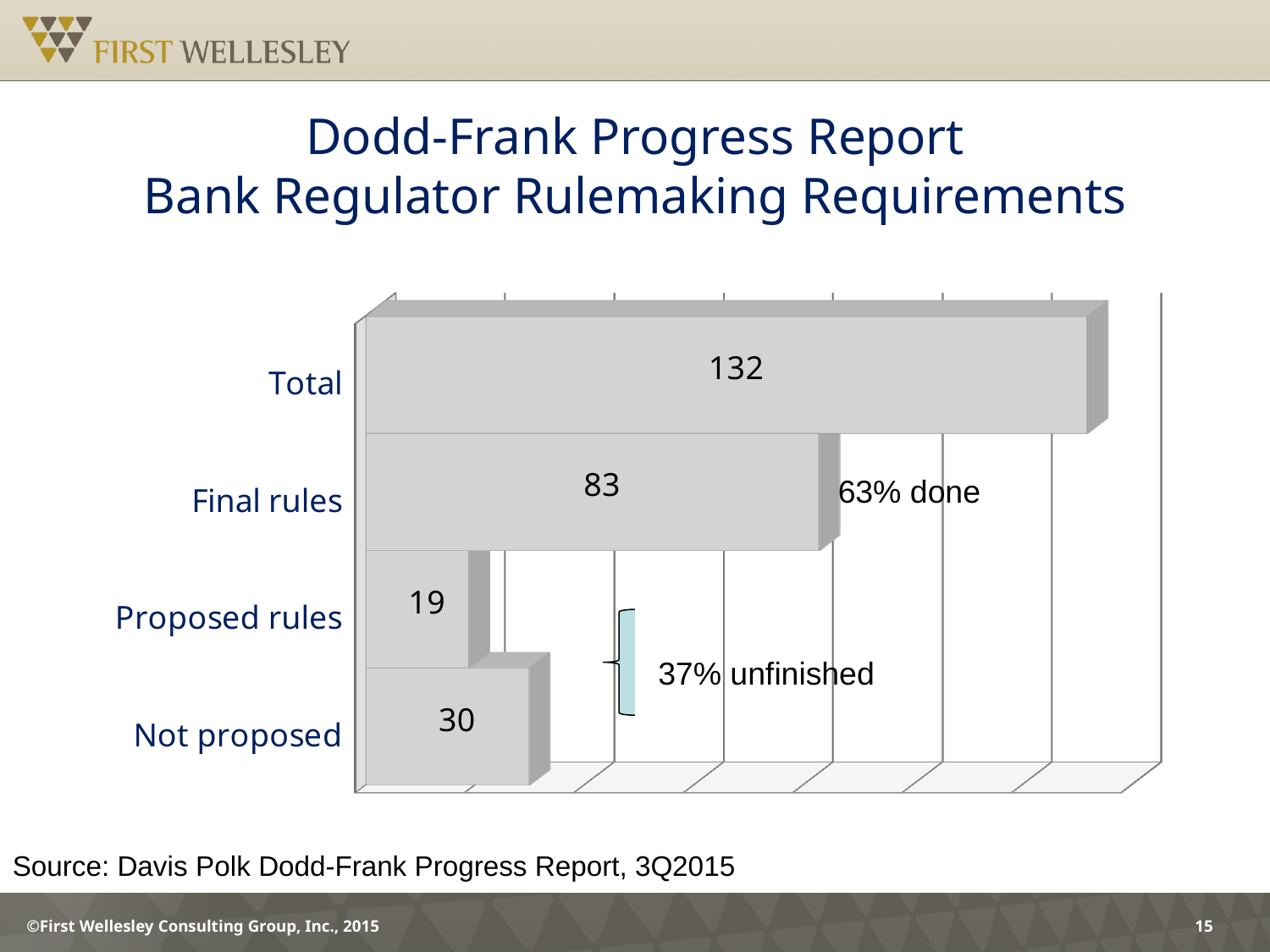
What is the value for Total? 132 What is the value for Proposed rules? 19 What is the difference between the Not proposed and Proposed rules values? 11 How many categories are shown on the chart? 4 What kind of chart is shown on the slide? Bar chart Which category has the lowest value? Proposed rules What is the value for Not proposed? 30 What is the difference between the Total and Final rules values? 49 Which category has the highest value? Total What is the value for Final rules? 83 Which is larger, Final rules or Not proposed? Final rules What percentage of rules does the chart annotation say is done? 63%